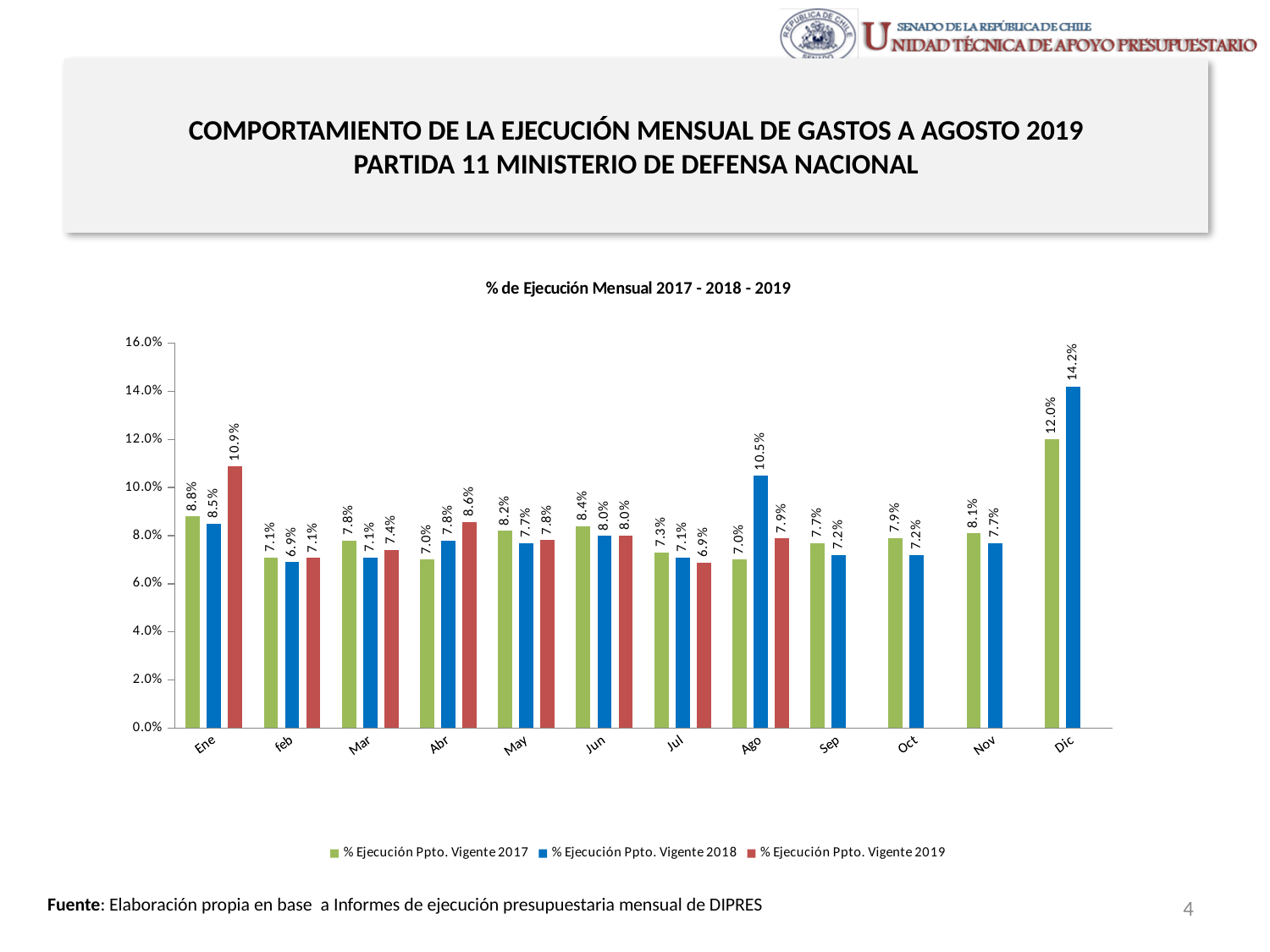
What is the difference between the 2018 and 2017 values in Dic? 2.2% Which month has the highest value for % Ejecución Ppto. Vigente 2018? Dic How many months are shown on the x axis? 12 What is the value for % Ejecución Ppto. Vigente 2019 in Ene? 10.9% What is the value for % Ejecución Ppto. Vigente 2017 in Dic? 12.0% What is the value for % Ejecución Ppto. Vigente 2018 in Ago? 10.5% In Abr, which is larger: the 2017 value or the 2019 value? 2019 Is the value for % Ejecución Ppto. Vigente 2018 in Dic greater or less than 14.0%? greater Which month has the lowest value for % Ejecución Ppto. Vigente 2019? Jul What kind of chart is shown on the slide? Bar chart How many series does the legend list? 3 What is the title of the chart? % de Ejecución Mensual 2017 - 2018 - 2019